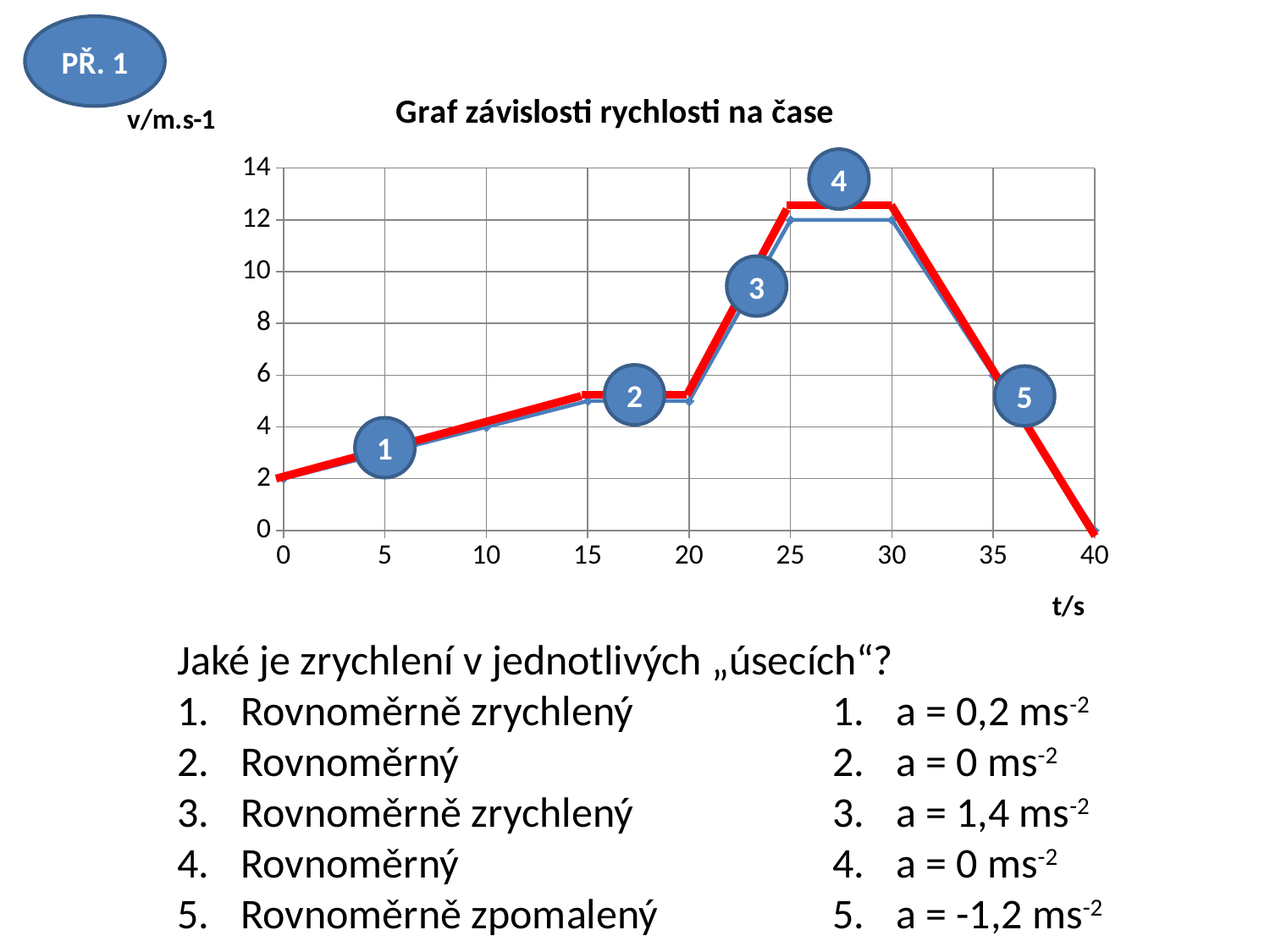
What is the value of v at t = 10? 4 What is the value of v at t = 35? 6 What is the label of the horizontal axis? t/s At which value of t is v lowest? 40 What is the difference between the value of v at t = 25 and at t = 0? 10 What is the highest value of v reached on the chart? 12 What is the value of v at t = 0? 2 Is the value of v at t = 20 greater or less than 6? less What is the value of v at t = 25? 12 Does the value of v rise or fall between t = 30 and t = 40? fall What kind of chart is shown on the slide? line chart What is the title of the chart? Graf závislosti rychlosti na čase